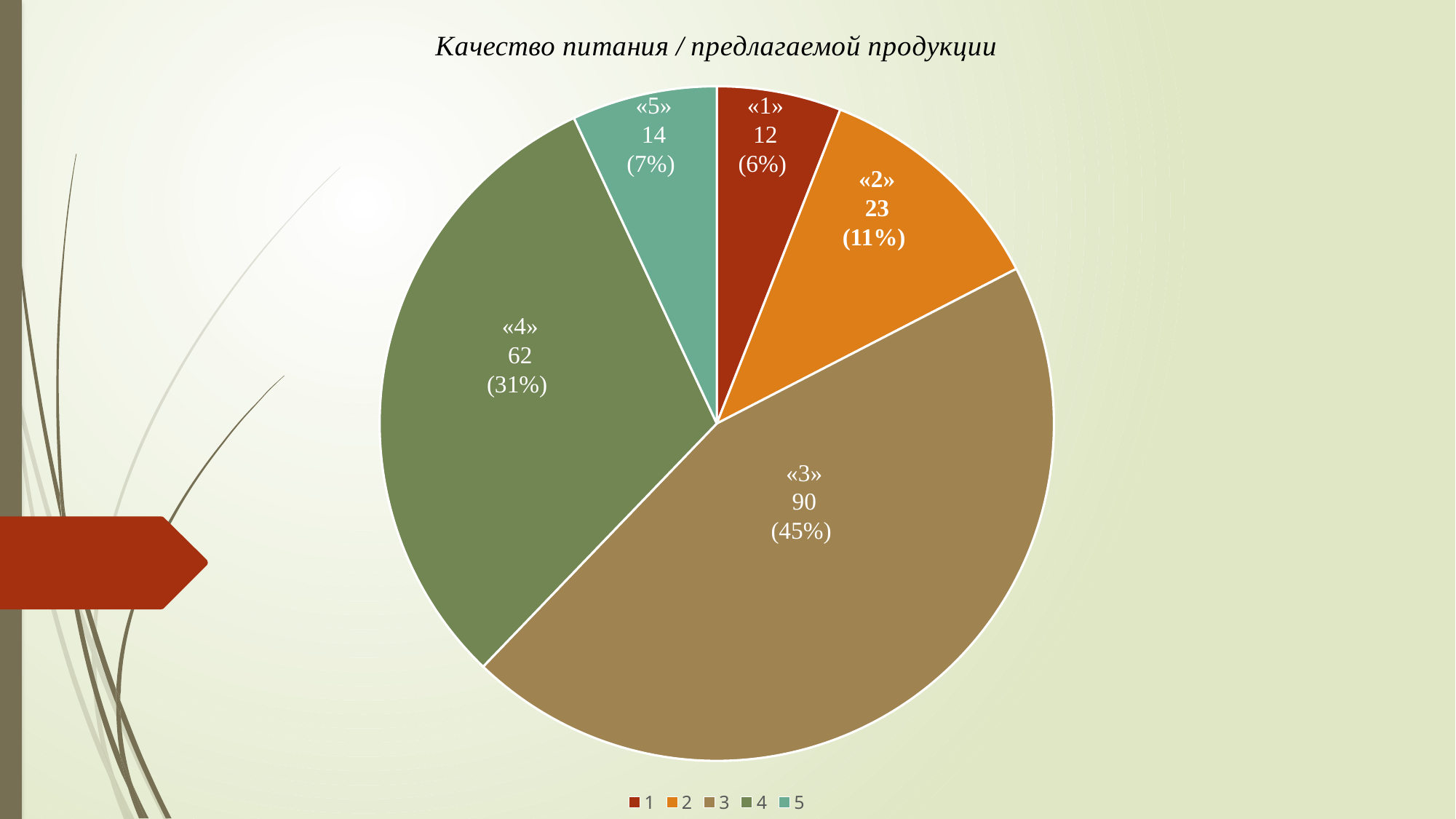
What type of chart is shown on the slide? pie chart How many entries does the legend list? 5 What percentage share does category «4» have? 31% What is the difference between the values for «3» and «4»? 28 What is the title of the chart? Качество питания / предлагаемой продукции Which is larger, the value for «2» or the value for «5»? «2» What percentage share does category «1» have? 6% What is the value for category «5»? 14 Which category has the largest slice? «3» How many slices does the pie chart have? 5 Which category has the smallest slice? «1» What is the value for category «3»? 90